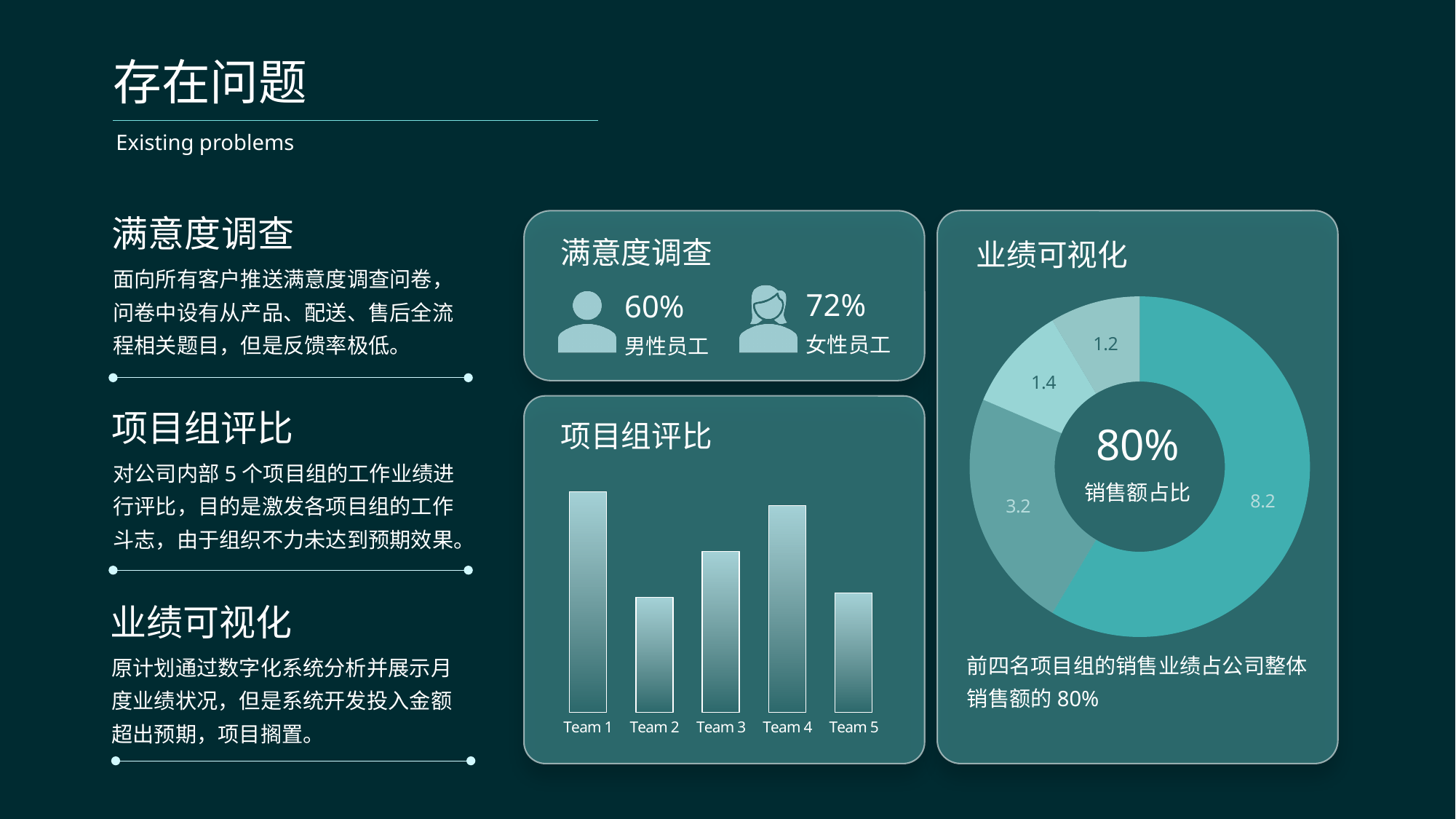
In the 项目组评比 bar chart, which bar is taller, Team 3 or Team 4? Team 4 In the 业绩可视化 doughnut chart, what is the smallest segment value? 1.2 In the 业绩可视化 doughnut chart, how many segments are there? 4 In the 业绩可视化 doughnut chart, what is the difference between the largest segment (8.2) and the second largest (3.2)? 5.0 In the 项目组评比 bar chart, which bar is taller, Team 4 or Team 5? Team 4 What percentage is printed in the centre of the 业绩可视化 doughnut chart? 80% In the 业绩可视化 doughnut chart, what is the largest segment value? 8.2 What kind of chart is shown in the 业绩可视化 panel? doughnut chart In the 项目组评比 bar chart, how many teams are shown? 5 In the 项目组评比 bar chart, which team has the tallest bar? Team 1 What kind of chart is shown in the 项目组评比 panel? bar chart In the 项目组评比 bar chart, which bar is taller, Team 1 or Team 2? Team 1